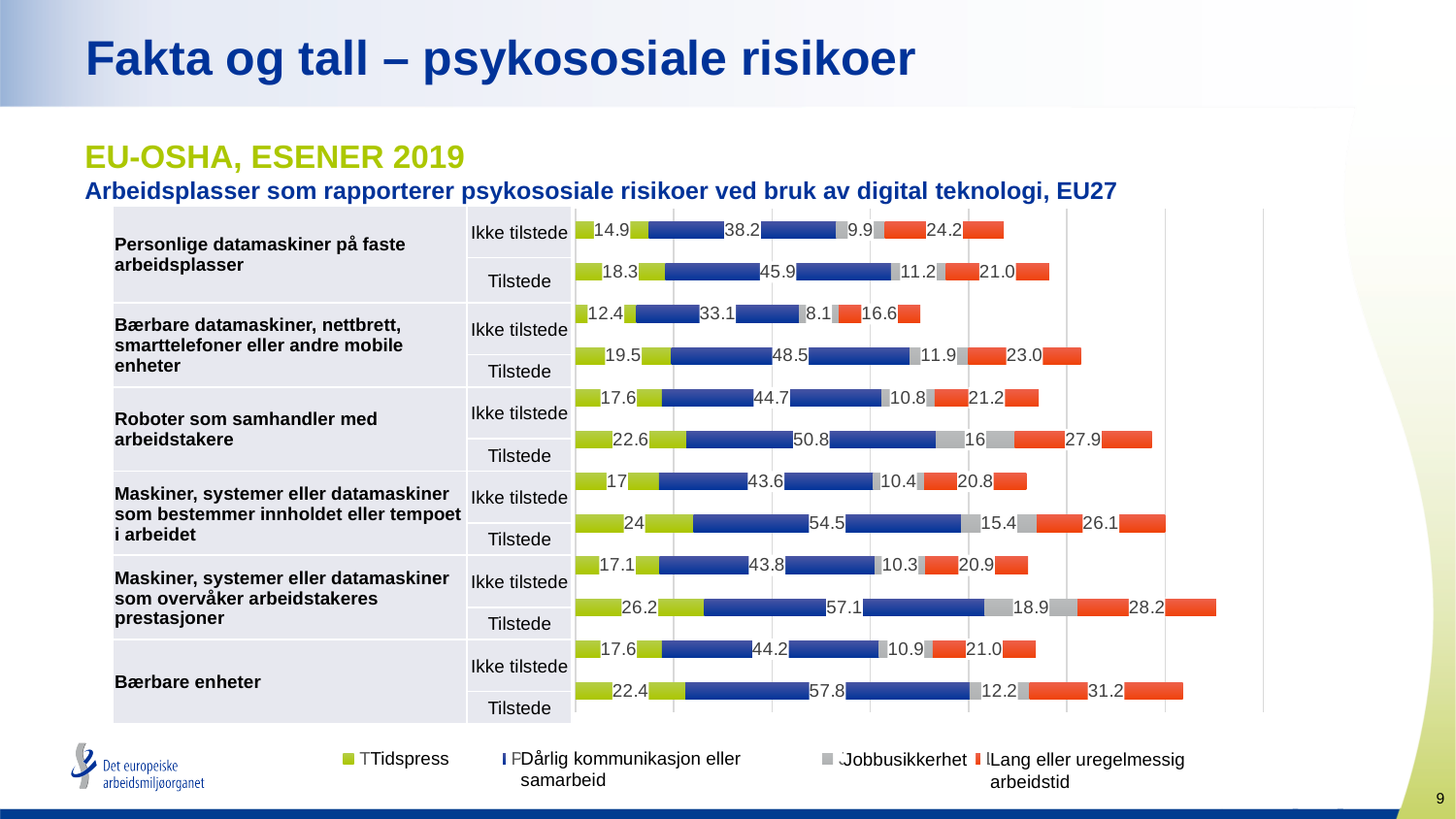
What is the Jobbusikkerhet value for 'Roboter som samhandler med arbeidstakere' when Tilstede? 16 Which bar has the lowest Tidspress value? Bærbare datamaskiner, nettbrett, smarttelefoner eller andre mobile enheter – Ikke tilstede How many stacked bars are plotted in the chart? 12 What is the 'Dårlig kommunikasjon eller samarbeid' value for 'Bærbare enheter' when Tilstede? 57.8 What is the difference in Tidspress between Tilstede and Ikke tilstede for 'Roboter som samhandler med arbeidstakere'? 5.0 What is the total of the stacked bar for 'Bærbare enheter' when Tilstede? 123.6 For 'Bærbare enheter', is the 'Lang eller uregelmessig arbeidstid' value larger when Tilstede or when Ikke tilstede? Tilstede What is the Tidspress value for 'Personlige datamaskiner på faste arbeidsplasser' when Tilstede? 18.3 What kind of chart is shown on the slide? Stacked bar chart What is the 'Lang eller uregelmessig arbeidstid' value for 'Bærbare datamaskiner, nettbrett, smarttelefoner eller andre mobile enheter' when Ikke tilstede? 16.6 How many series does the legend list? 4 Which bar has the highest Tidspress value? Maskiner, systemer eller datamaskiner som overvåker arbeidstakeres prestasjoner – Tilstede